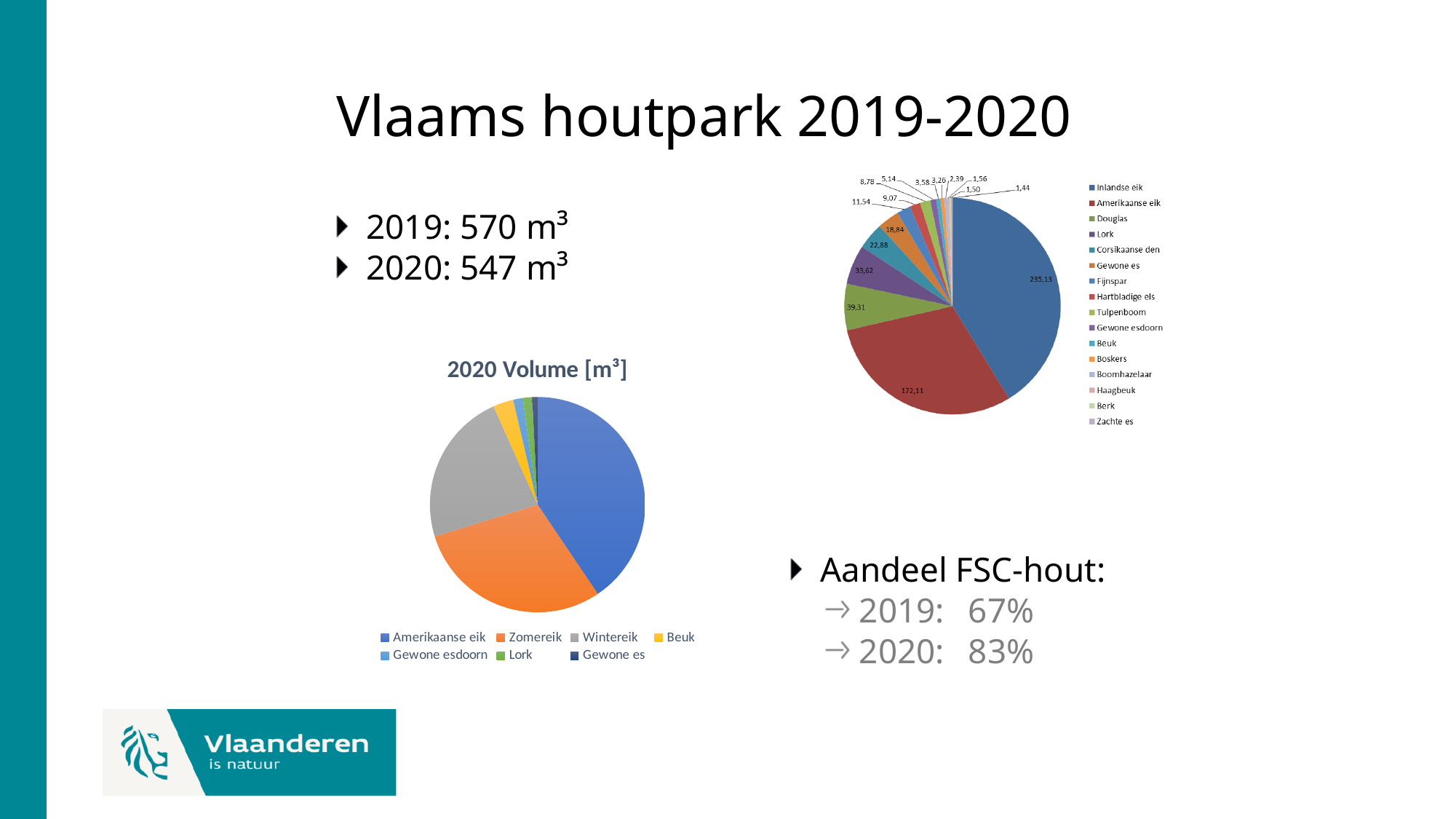
In the "2020 Volume [m³]" chart, which category has the largest slice? Amerikaanse eik In the pie chart at the top right of the slide, what is the value for Inlandse eik? 235,13 In the "2020 Volume [m³]" chart, which slice is larger, Zomereik or Wintereik? Zomereik In the pie chart at the top right of the slide, which category has the lowest value? Zachte es In the pie chart at the top right of the slide, what is the difference between the values for Inlandse eik and Amerikaanse eik? 63,02 In the pie chart at the top right of the slide, which category has the highest value? Inlandse eik In the pie chart at the top right of the slide, what is the value for Amerikaanse eik? 172,11 What is the title of the pie chart on the lower left of the slide? 2020 Volume [m³] How many categories does the legend of the pie chart at the top right of the slide list? 16 In the pie chart at the top right of the slide, what is the value for Douglas? 39,31 How many categories does the legend of the "2020 Volume [m³]" chart list? 7 What type of chart is the chart titled "2020 Volume [m³]"? pie chart